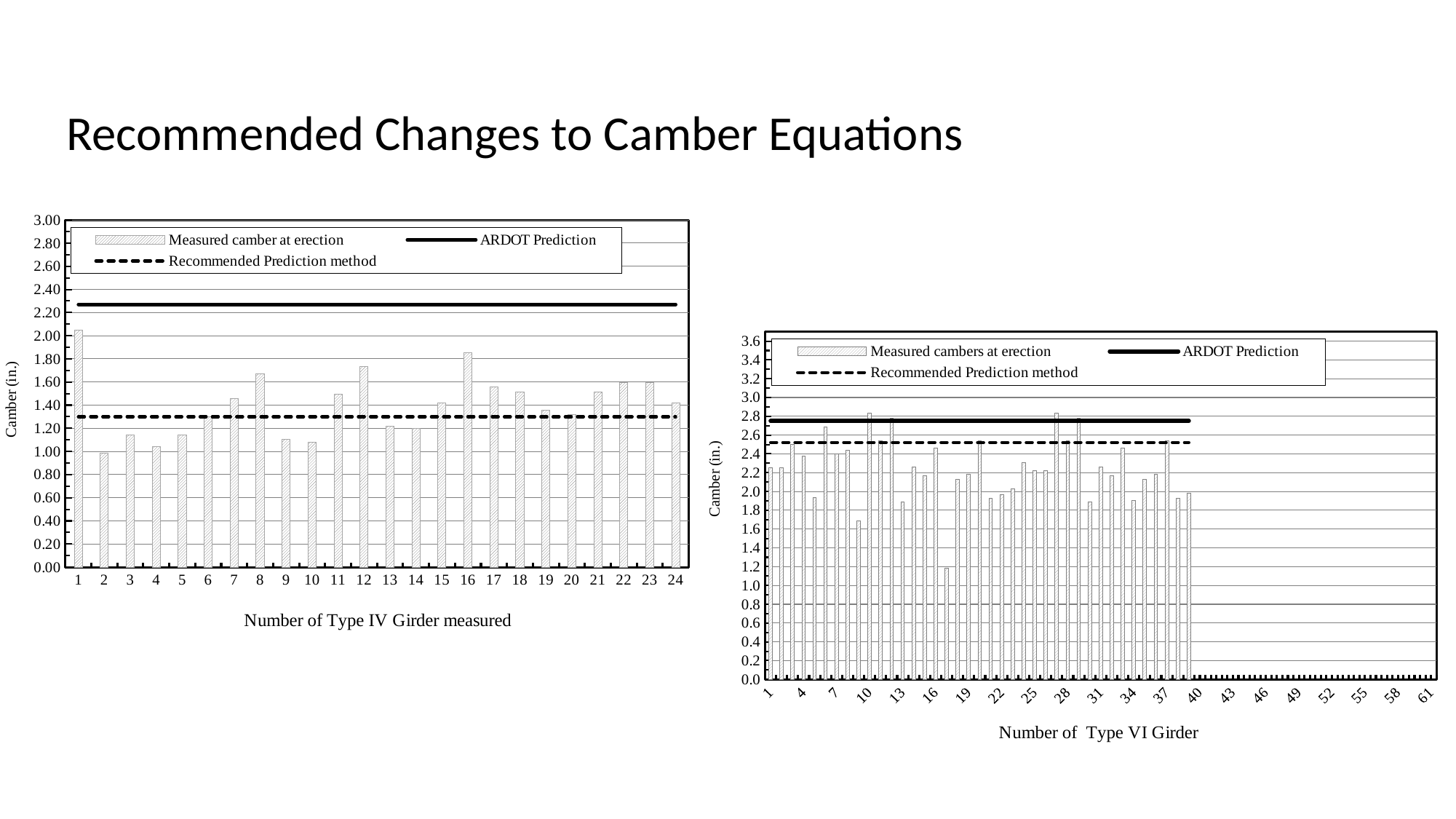
On the right chart (Number of Type VI Girder), which girder number has the lowest measured camber at erection? 17 On the left chart (Number of Type IV Girder measured), which girder number has the highest measured camber at erection? 1 On the left chart (Number of Type IV Girder measured), how many girders are plotted on the x axis? 24 What kind of chart is the right chart (Number of Type VI Girder)? combination bar and line chart How many series does the legend of the left chart (Number of Type IV Girder measured) list? 3 On the left chart (Number of Type IV Girder measured), which girder number has the lowest measured camber at erection? 2 On the left chart (Number of Type IV Girder measured), which is larger: the measured camber for girder 1 or for girder 16? girder 1 On the right chart (Number of Type VI Girder), which line is higher: the ARDOT Prediction or the Recommended Prediction method? ARDOT Prediction On the right chart (Number of Type VI Girder), is the measured camber for girder 18 greater or less than 1.4? greater On the left chart (Number of Type IV Girder measured), which line is higher: the ARDOT Prediction or the Recommended Prediction method? ARDOT Prediction On the left chart (Number of Type IV Girder measured), is the measured camber for girder 9 greater or less than 1.20? less On the left chart (Number of Type IV Girder measured), is the measured camber for girder 12 greater or less than 1.60? greater